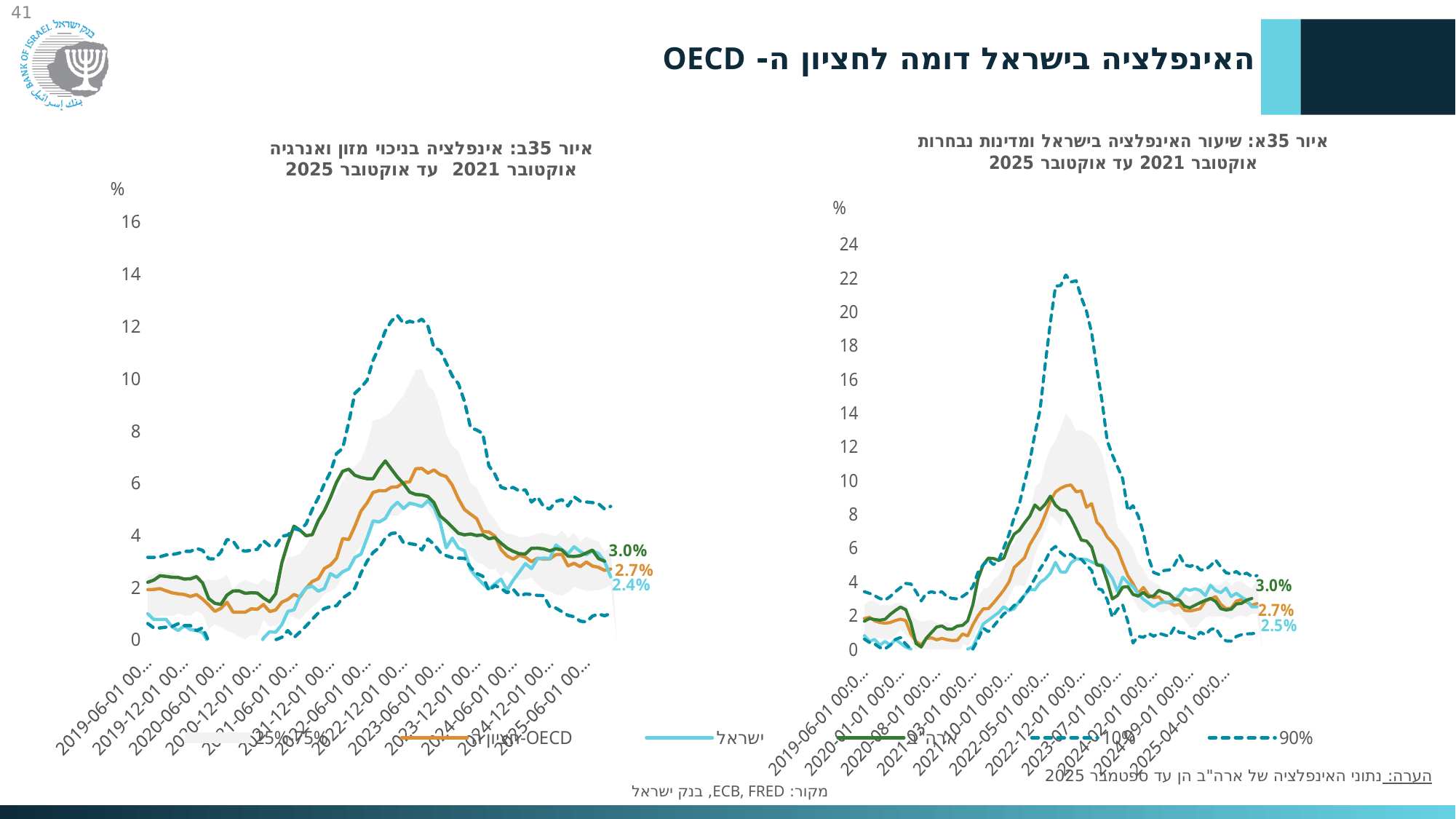
In the right-hand chart (איור 35א), what is the latest value labelled for the green ארה"ב line? 3.0% In the right-hand chart (איור 35א), what is the latest value labelled for the light-blue ישראל line? 2.5% In the left-hand chart (איור 35ב), is the peak of the upper dashed line greater or less than 10? greater What kind of chart is the left-hand chart (איור 35ב)? line chart What kind of chart is the right-hand chart (איור 35א)? line chart In the left-hand chart (איור 35ב), which has the higher latest labelled value: the green line or the orange line? the green line In the left-hand chart (איור 35ב), what is the latest value labelled for the light-blue line? 2.4% In the right-hand chart (איור 35א), is the peak of the dashed 90% line greater or less than 20? greater In the right-hand chart (איור 35א), what is the difference between the latest labelled values of the green line (3.0%) and the light-blue ישראל line (2.5%)? 0.5% In the left-hand chart (איור 35ב), what is the latest value labelled for the green line? 3.0% In the right-hand chart (איור 35א), what is the latest value labelled for the orange line? 2.7%